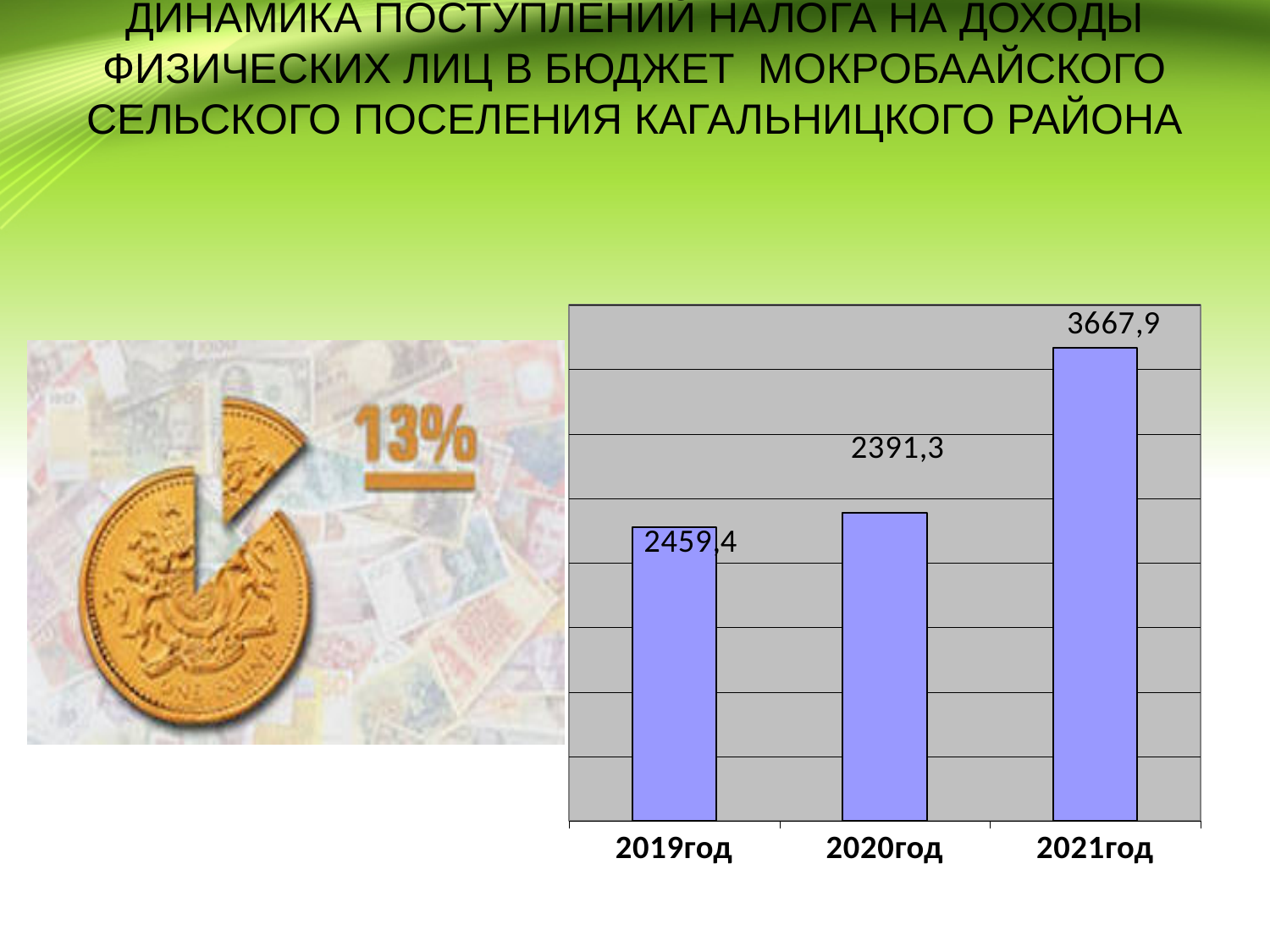
What is the difference between the values for 2021год and 2020год? 1276,6 What is the value for 2020год? 2391,3 What is the first year shown on the x axis of the chart? 2019год What is the difference between the values for 2021год and 2019год? 1208,5 What kind of chart is shown on the slide? Bar chart Which is larger, the value for 2021год or the value for 2020год? 2021год Which is larger, the value for 2021год or the value for 2019год? 2021год How many years are shown on the chart? 3 What is the value for 2021год? 3667,9 What is the value for 2019год? 2459,4 What colour are the bars in the chart? Blue Which year has the highest value? 2021год